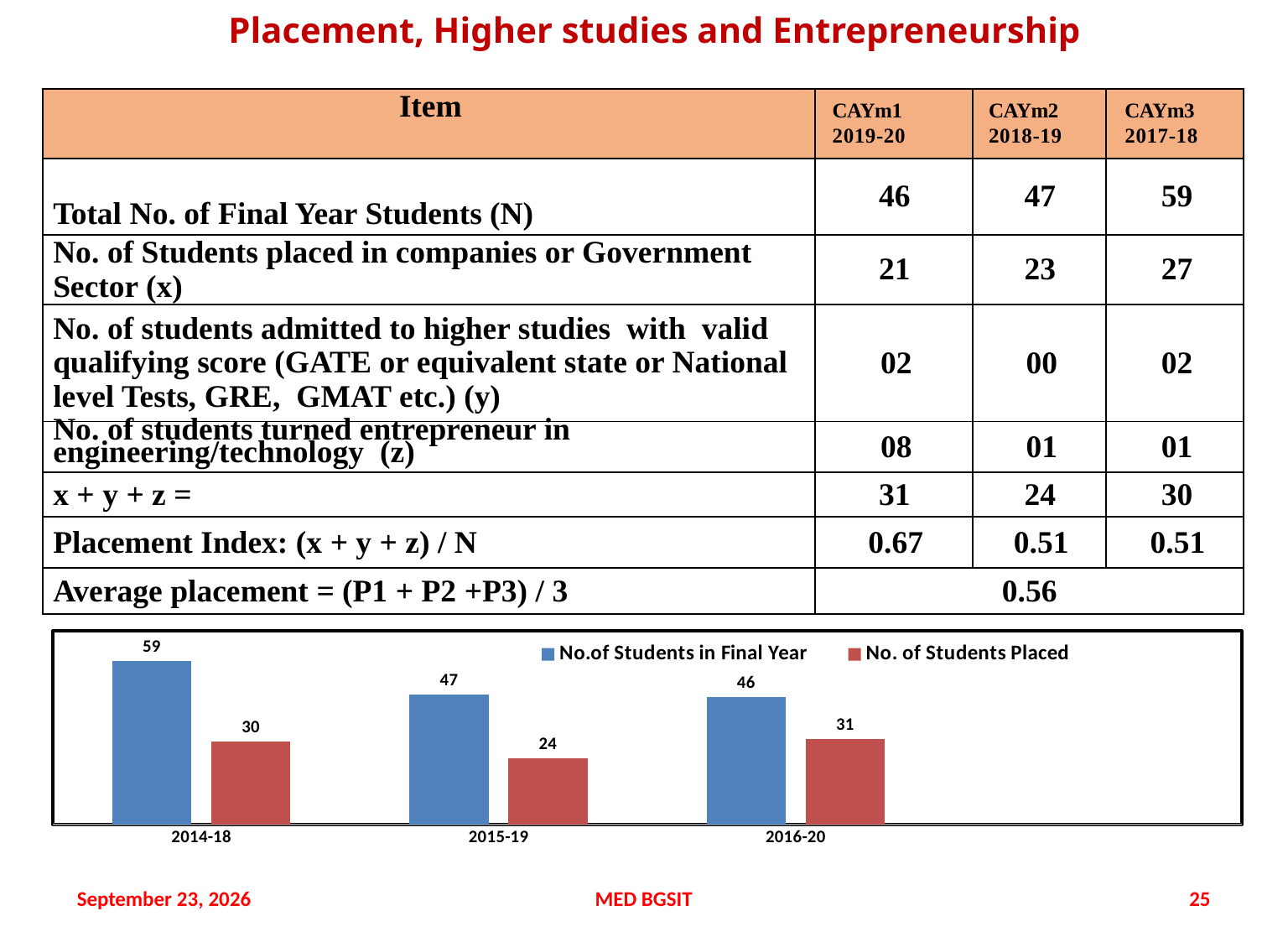
Which category has the highest value for No.of Students in Final Year? 2014-18 Which category has the lowest value for No. of Students Placed? 2015-19 How many categories are shown on the x axis of the chart? 3 What kind of chart is shown on the slide? bar chart What is the value for No.of Students in Final Year for 2014-18? 59 Do the values for No.of Students in Final Year rise or fall from 2014-18 to 2016-20? fall How many series does the chart legend list? 2 What is the value for No. of Students Placed for 2016-20? 31 Which is larger: No. of Students Placed for 2014-18 or for 2016-20? 2016-20 What is the difference between No.of Students in Final Year for 2015-19 and 2016-20? 1 What is the value for No. of Students Placed for 2015-19? 24 What is the difference between No.of Students in Final Year and No. of Students Placed for 2014-18? 29